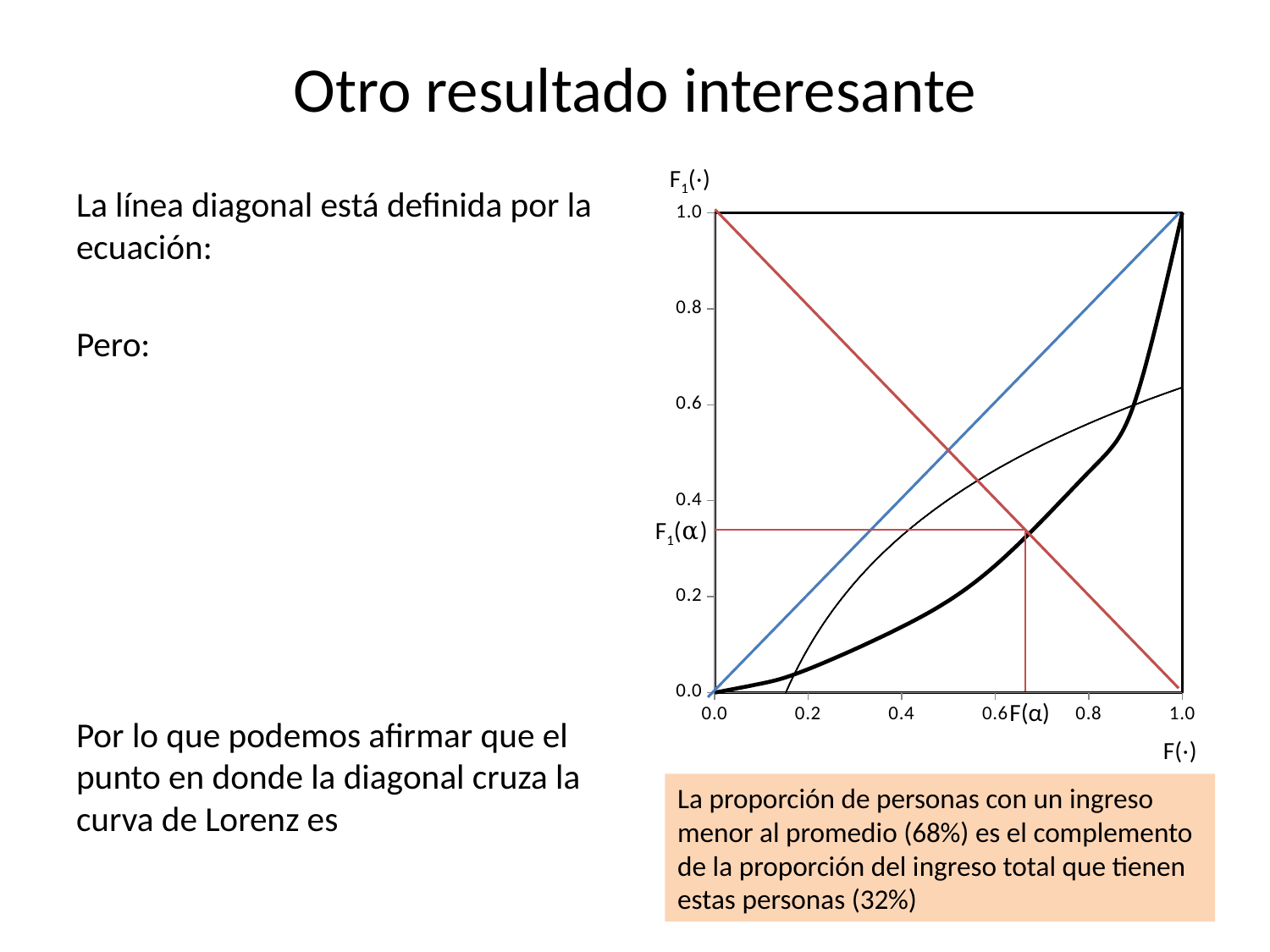
What is the label of the vertical axis of the chart? F₁(·) Does the thick black Lorenz curve rise or fall as F(·) increases from 0.0 to 1.0? rises What is the highest tick value shown on the vertical axis? 1.0 What is the value of the thick black Lorenz curve at F(·) = 1.0? 1.0 Does the red diagonal line rise or fall as F(·) increases from 0.0 to 1.0? falls Is the value F₁(α) marked on the vertical axis greater or less than 0.4? less What kind of chart is shown on the slide? line chart Is the value of the thick black curve at F(·) = 0.8 greater or less than 0.6? less How many tick labels are printed along the horizontal axis? 6 Is the value F(α) marked on the horizontal axis greater or less than 0.6? greater What is the label of the horizontal axis of the chart? F(·) What is the value of the thick black Lorenz curve at F(·) = 0.0? 0.0